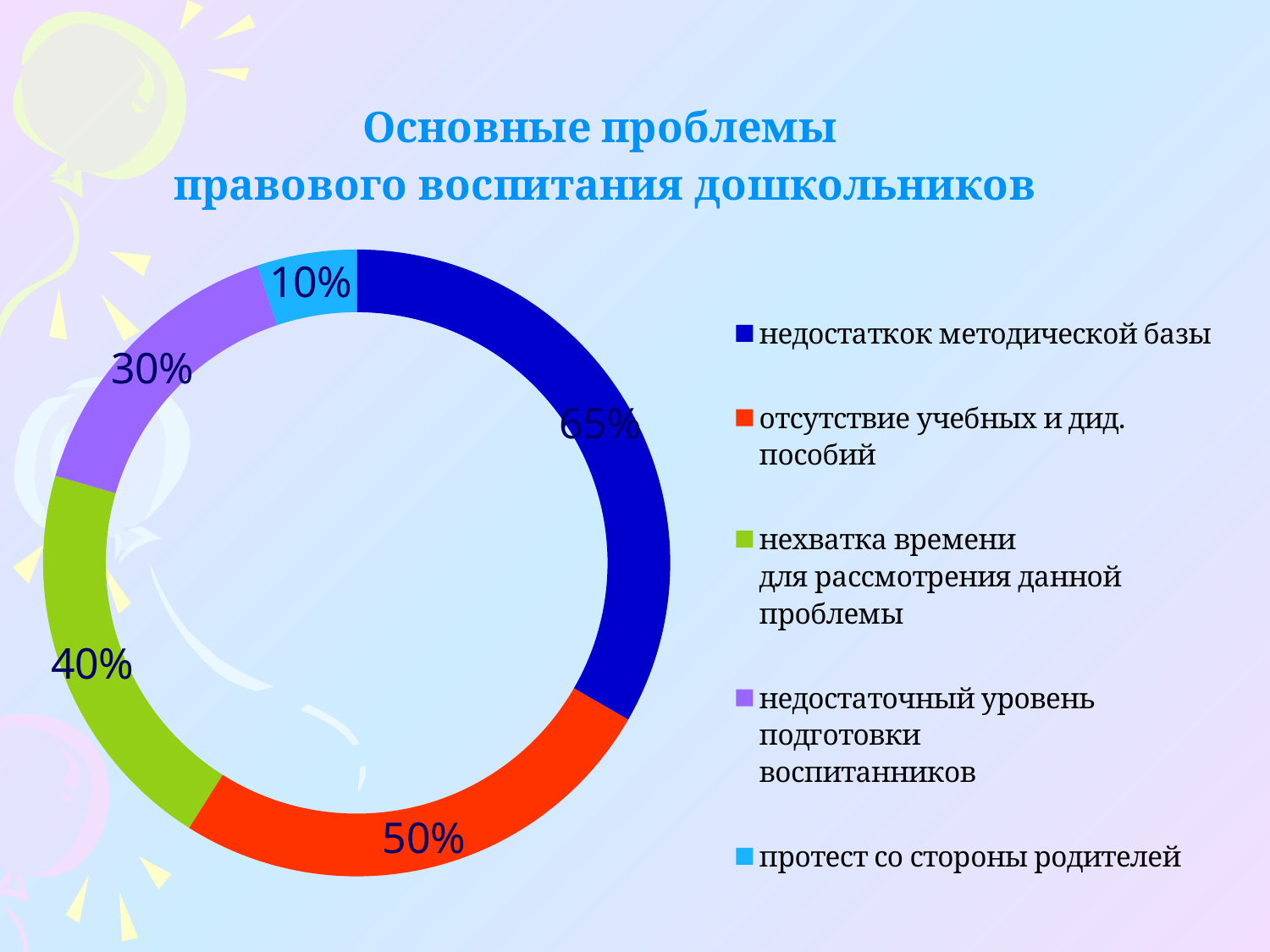
What value is shown for "недостаткок методической базы"? 65% What kind of chart is shown on the slide? Doughnut chart Which is larger: the value for "нехватка времени для рассмотрения данной проблемы" or for "недостаточный уровень подготовки воспитанников"? нехватка времени для рассмотрения данной проблемы What value is shown for "протест со стороны родителей"? 10% What value is shown for "недостаточный уровень подготовки воспитанников"? 30% Which category has the highest value? недостаткок методической базы What value is shown for "нехватка времени для рассмотрения данной проблемы"? 40% Which category has the lowest value? протест со стороны родителей What colour is the segment for "протест со стороны родителей"? Light blue How many categories does the chart show? 5 What value is shown for "отсутствие учебных и дид. пособий"? 50% What is the difference between the values for "недостаткок методической базы" and "отсутствие учебных и дид. пособий"? 15%